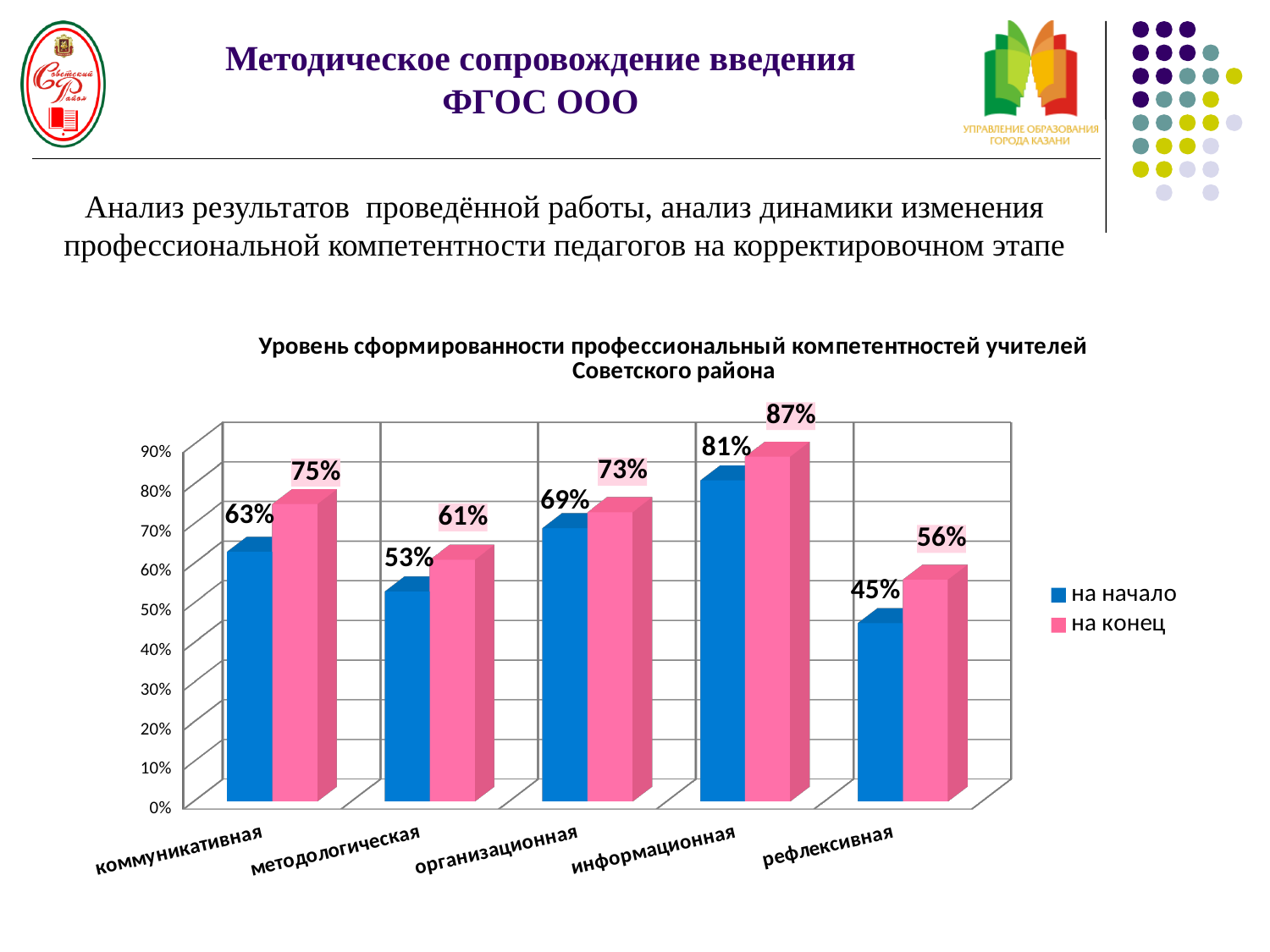
What colour are the bars for the "на конец" series? pink Which is larger: the "на конец" value for организационная or the "на конец" value for коммуникативная? коммуникативная What is the value for "на начало" for коммуникативная? 63% How many series does the legend list? 2 Which category has the lowest value for "на начало"? рефлексивная What is the difference between the "на начало" values for информационная and методологическая? 28% What is the value for "на конец" for методологическая? 61% How many categories are shown on the x axis? 5 Which category has the highest value for "на конец"? информационная What kind of chart is shown on the slide? bar chart What is the difference between the "на конец" and "на начало" values for рефлексивная? 11% What is the value for "на конец" for рефлексивная? 56%